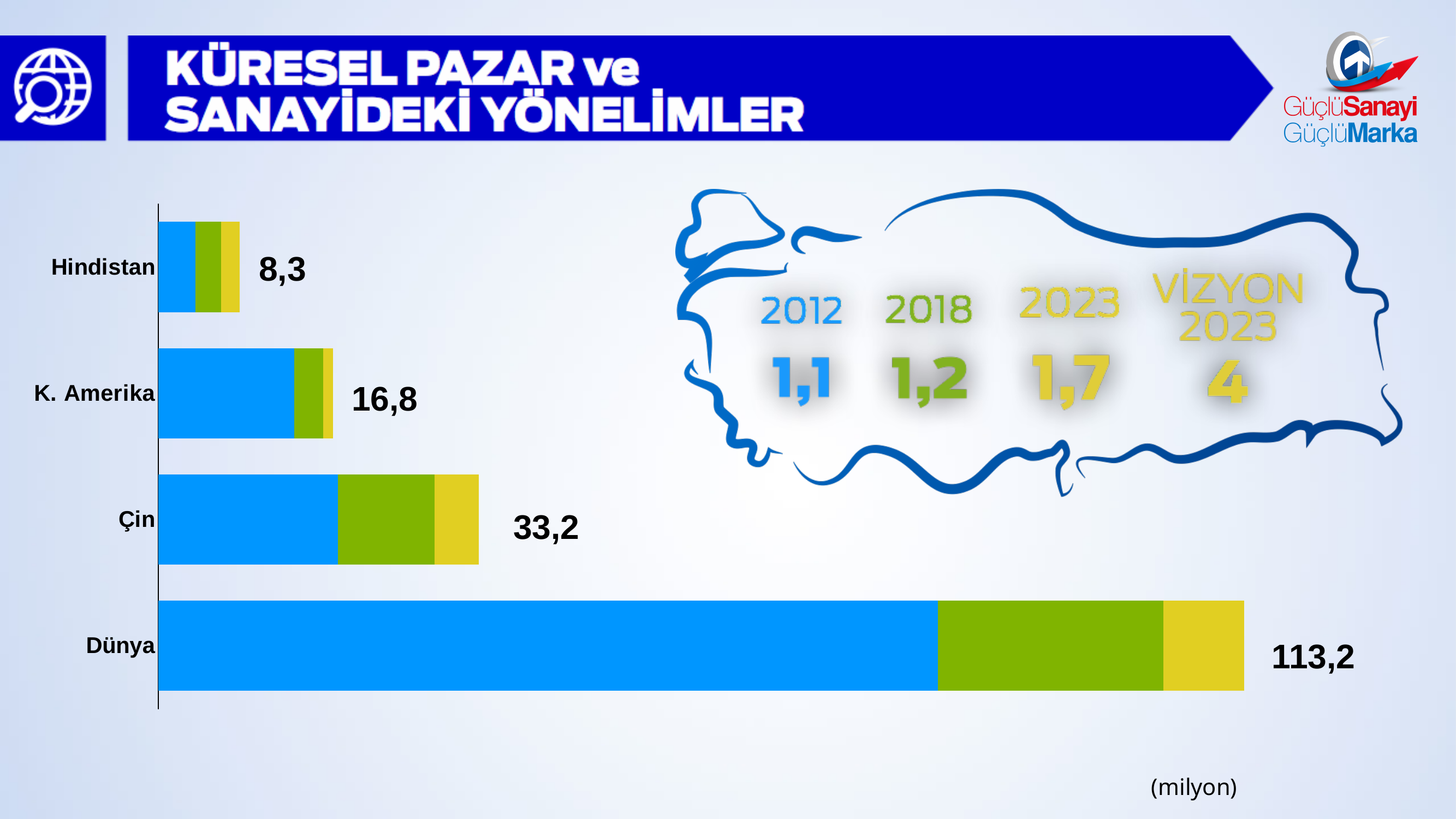
What is the difference between the values printed for Çin and K. Amerika? 16,4 Which is larger, the value for Çin or the value for K. Amerika? Çin What value is printed next to the bar for Dünya? 113,2 What value is printed next to the bar for K. Amerika? 16,8 How many coloured segments does each bar consist of? 3 What kind of chart is shown on the slide? bar chart What unit is indicated at the bottom right of the chart? (milyon) Which category has the shortest bar? Hindistan What value is printed next to the bar for Çin? 33,2 Which category has the longest bar? Dünya What value is printed next to the bar for Hindistan? 8,3 How many categories are shown on the bar chart? 4